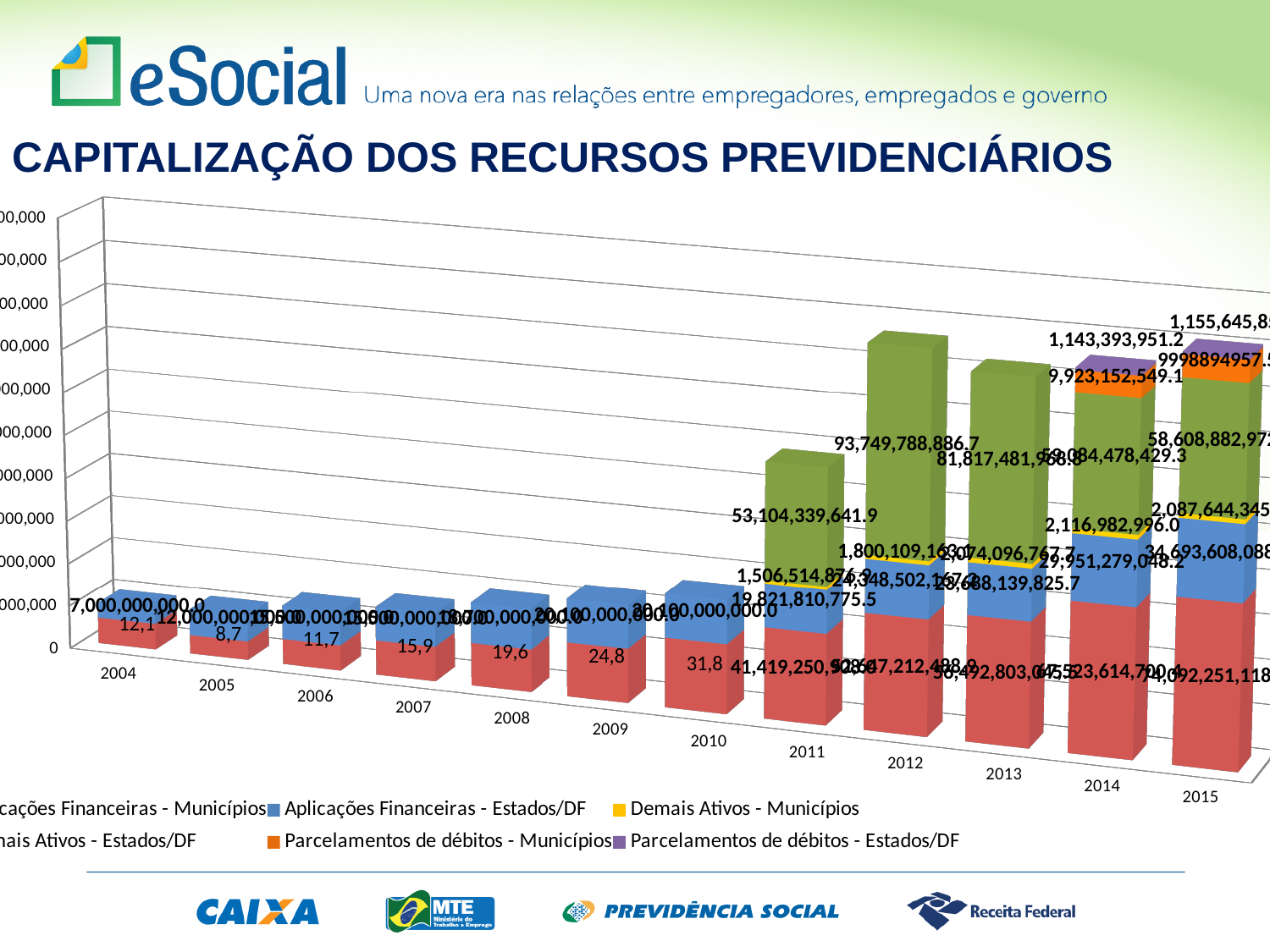
How many series does the chart legend list? 6 What value is labelled on the green segment for 2011? 53,104,339,641.9 What is the value of Aplicações Financeiras - Estados/DF for 2014? 29,951,279,048.2 What is the value of Parcelamentos de débitos - Estados/DF for 2014? 1,143,393,951.2 What is the value of Aplicações Financeiras - Estados/DF for 2013? 23,688,139,825.7 What value is labelled on the green segment for 2012? 93,749,788,886.7 In which year is the green segment the largest? 2012 What is the title of the chart on the slide? CAPITALIZAÇÃO DOS RECURSOS PREVIDENCIÁRIOS What is the difference between the green segment values for 2012 and 2011? 40,645,449,244.8 What is the value of Parcelamentos de débitos - Municípios for 2014? 9,923,152,549.1 What kind of chart is shown on the slide? Stacked bar chart How many years are shown along the x axis of the chart? 12